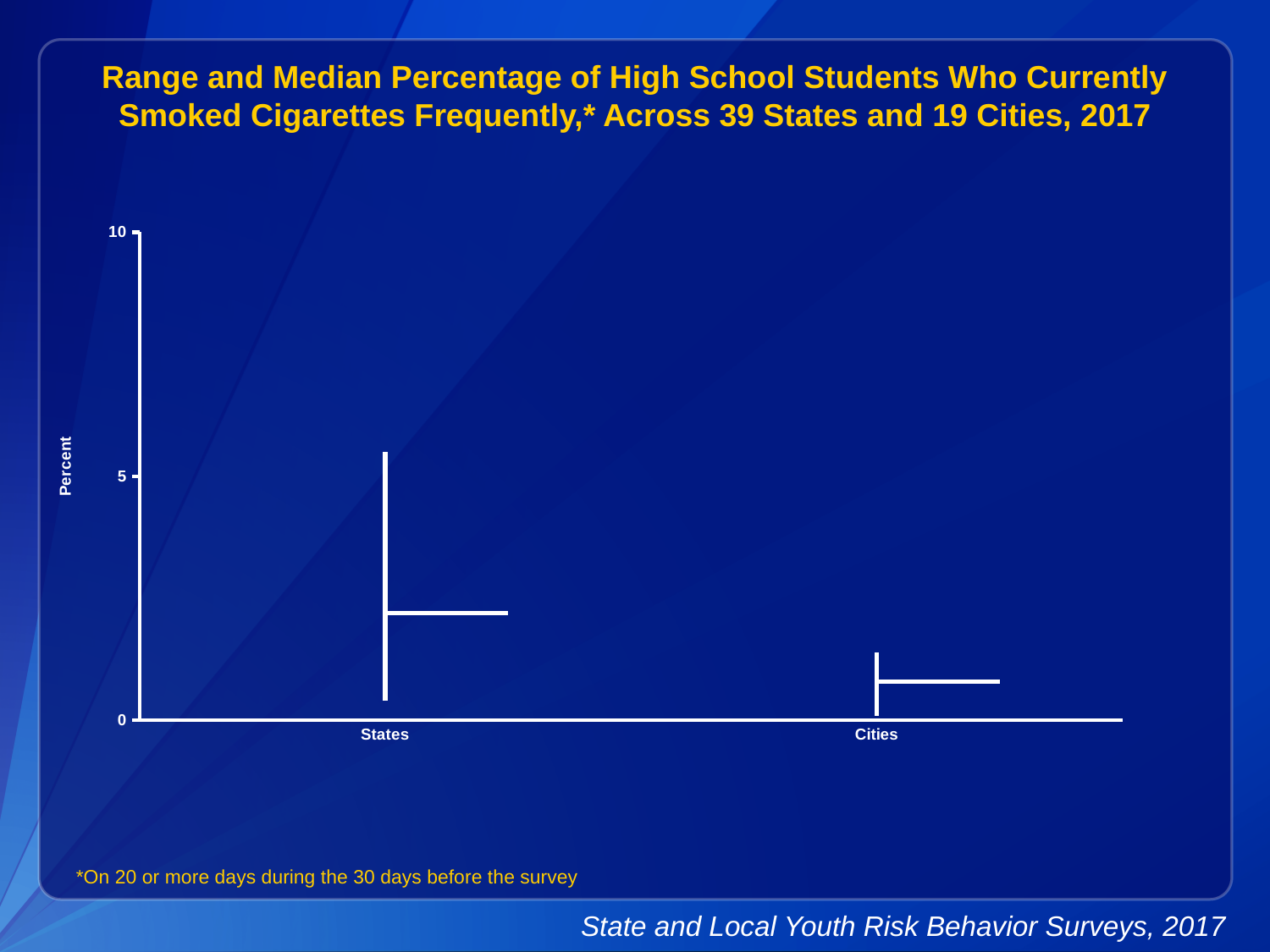
What is the highest value shown on the y axis? 10 What is the label on the y axis of the chart? Percent Is the median value for States greater or less than 5? less Is the top of the range for States greater or less than 5? greater Which category has the lower median percentage? Cities Which category has the higher median percentage, States or Cities? States What are the two categories shown on the x axis? States and Cities Is the top of the range for Cities greater or less than 5? less How many categories are shown on the x axis of the chart? 2 Which category shows the wider range of percentages? States